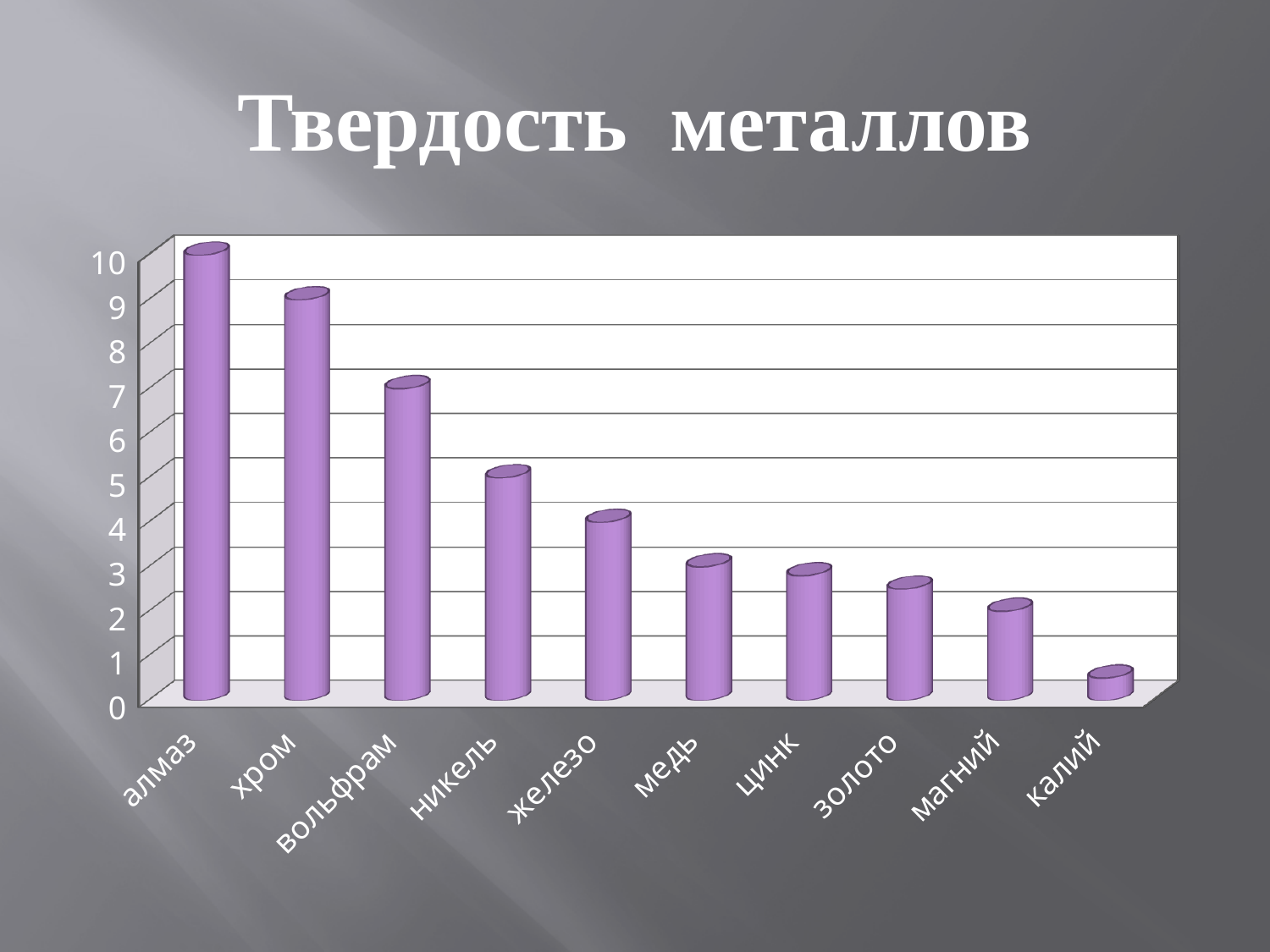
Is the value for хром greater or less than 8? greater Which is larger, the value for никель or the value for медь? никель Is the value for вольфрам greater or less than 6? greater What kind of chart is shown on the slide? bar chart Which category has the highest value? алмаз Do the values rise or fall moving from left to right along the x axis? fall Is the value for золото greater or less than 3? less Which category has the lowest value? калий How many categories (metals) are plotted on the chart? 10 What is the title of the chart? Твердость металлов What is the value for алмаз? 10